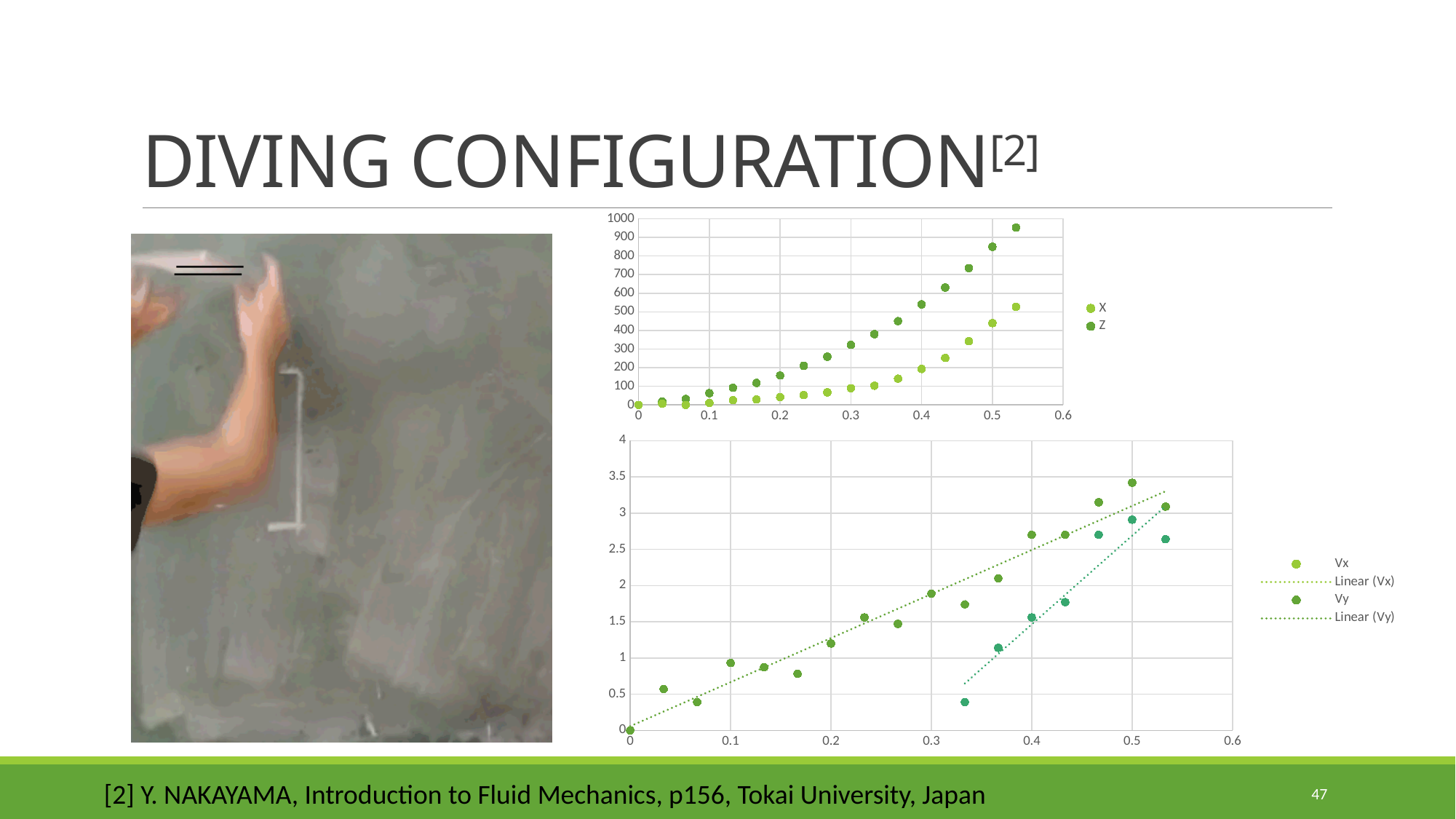
What are the names of the two series in the legend of the top chart? X and Z In the top chart, is the value of the Z series at x = 0.5 greater or less than 800? greater How many series does the legend of the top chart list? 2 How many entries does the legend of the bottom chart list? 4 In the top chart, is the value of the X series at x = 0.5 greater or less than 500? less What kind of chart is the top chart on the right of the slide? scatter chart In the top chart, at x = 0.5, which series has the larger value, X or Z? Z In the bottom chart, is the value of the Vy series at x = 0.5 greater or less than 3? greater In the top chart, do the values of the Z series rise or fall as x increases? rise